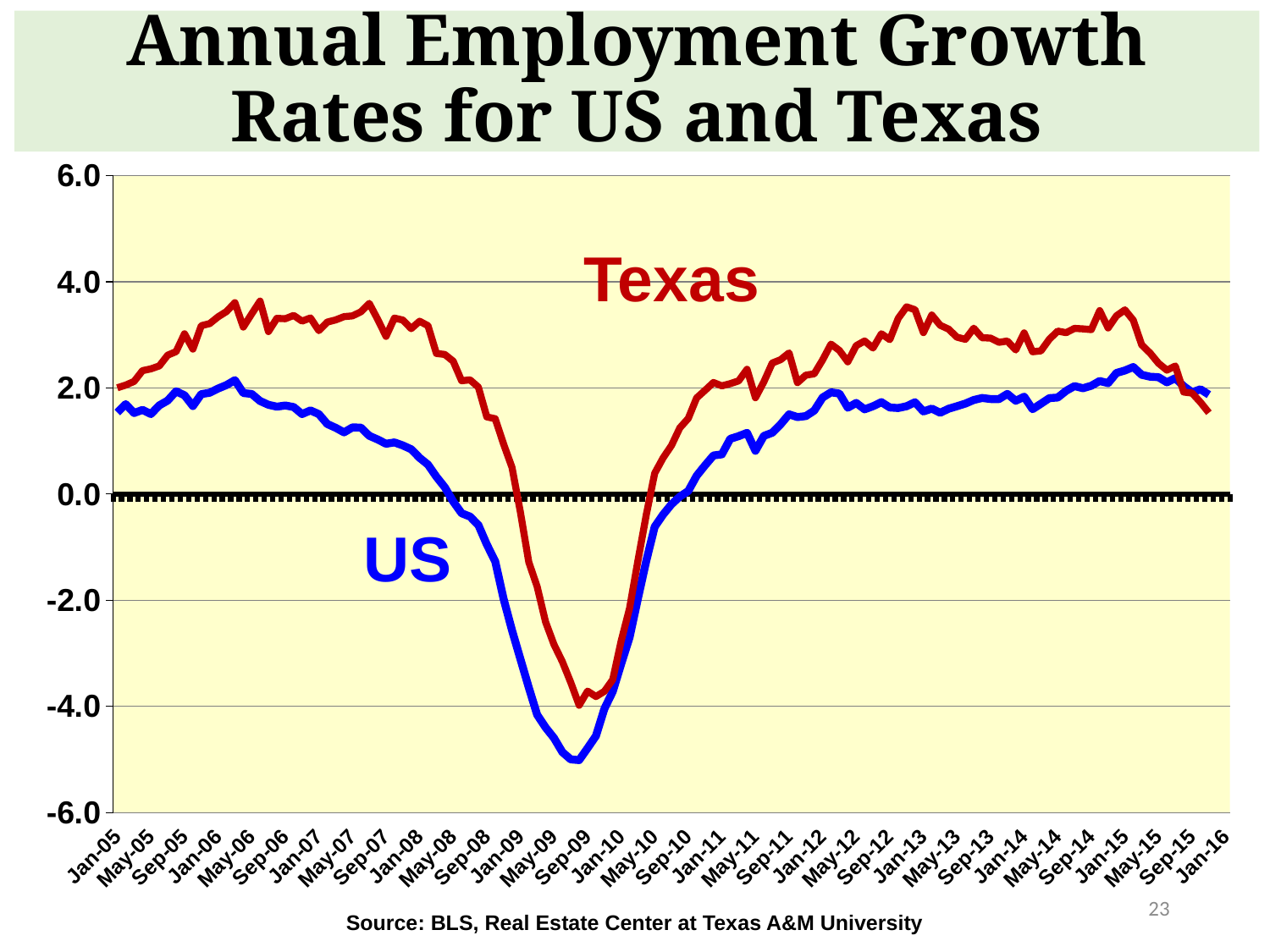
Which series reaches the lowest value on the chart? US Does the Texas line rise or fall between Sep-09 and Jan-11? rise Is the value for Texas at Jan-13 greater or less than 2.0? greater Is the value for US at Jan-13 greater or less than 2.0? less Is the value for Texas at May-06 greater or less than 2.0? greater Which colour is used for the Texas line? red How many series are plotted on the chart? 2 What kind of chart is shown on the slide? line chart Does the US line rise or fall between May-08 and Sep-09? fall What is the title of the chart? Annual Employment Growth Rates for US and Texas Which series has the higher value at Jan-13, Texas or US? Texas